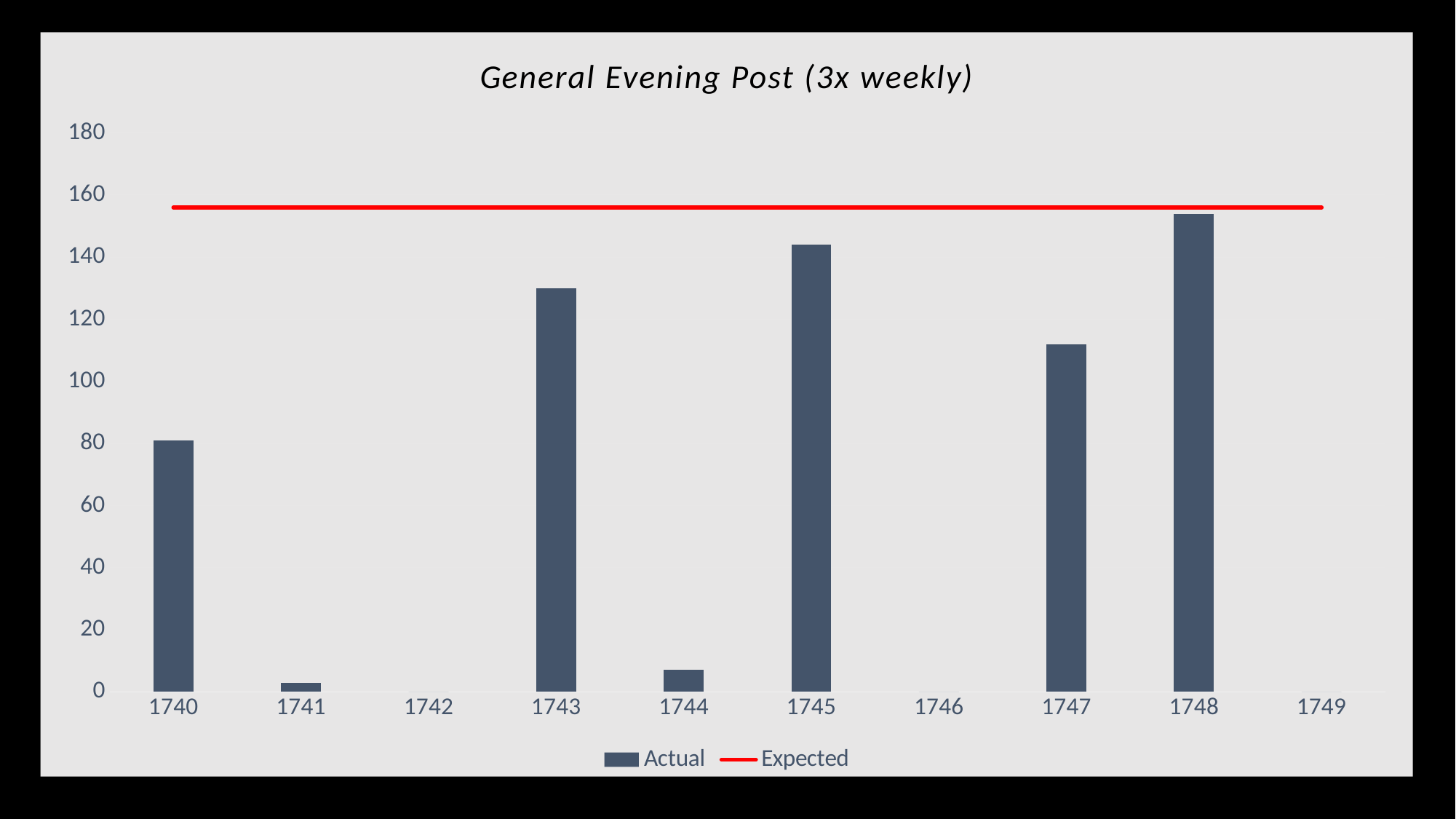
Is the Actual value for 1743 greater or less than 120? greater What kind of chart is shown on the slide? combination bar and line chart Is the Actual value for 1740 greater or less than 100? less Which year has the highest Actual bar? 1748 Is the Actual value for 1748 greater or less than 160? less Which year has the larger Actual value, 1745 or 1748? 1748 How many years are shown along the x axis? 10 How many series does the legend list? 2 Which year has the larger Actual value, 1743 or 1747? 1743 What is the title of the chart? General Evening Post (3x weekly) What colour is the Expected line in the chart? red